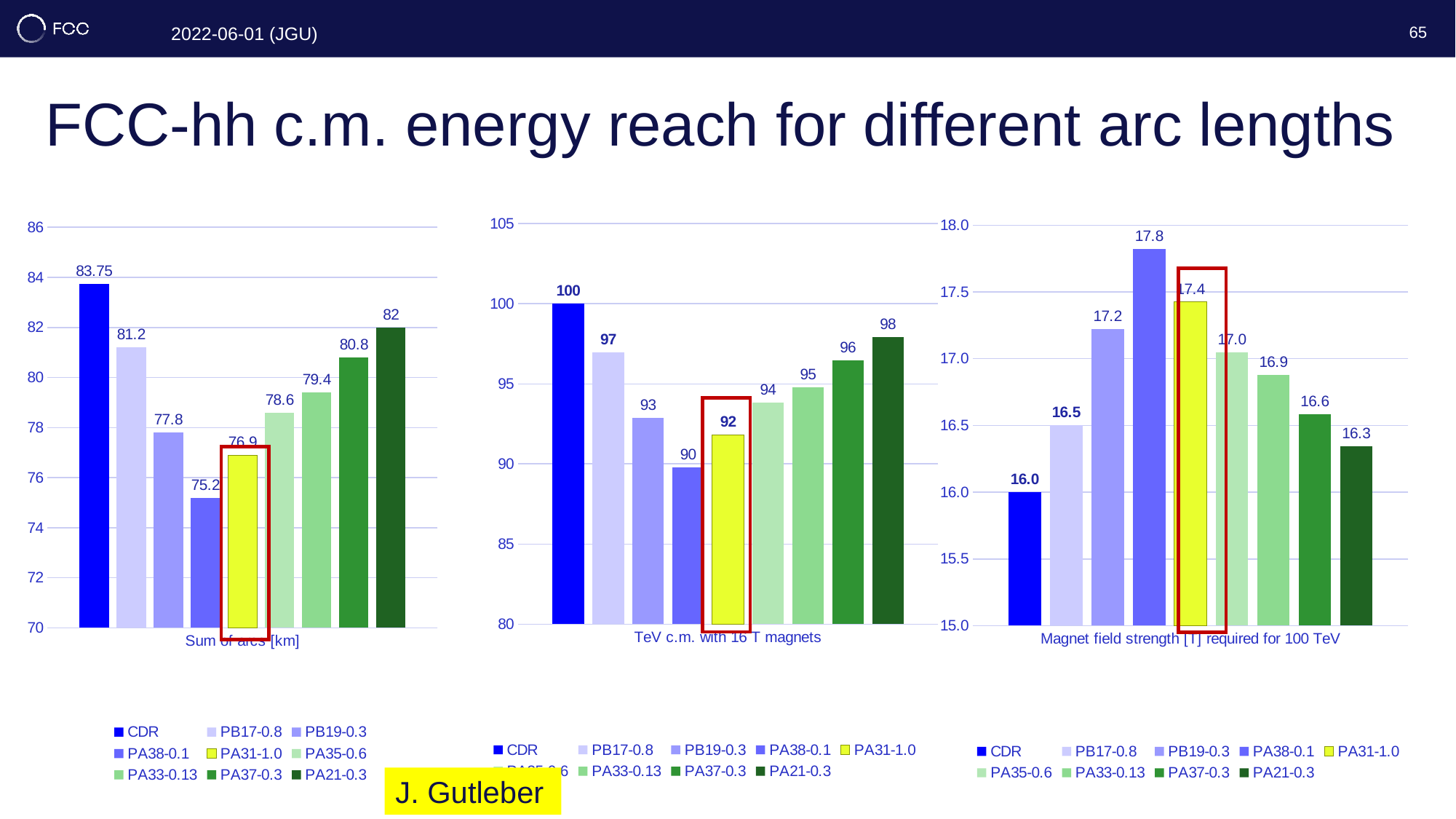
In the 'Sum of arcs [km]' chart, what is the value for CDR? 83.75 In the 'TeV c.m. with 16 T magnets' chart, which is larger, the value for PB19-0.3 or the value for PA33-0.13? PA33-0.13 In the 'TeV c.m. with 16 T magnets' chart, what is the value for PA31-1.0? 92 In the 'Sum of arcs [km]' chart, what is the difference between the CDR value and the PA21-0.3 value? 1.75 In the 'TeV c.m. with 16 T magnets' chart, which series has the highest value? CDR In the 'Magnet field strength [T] required for 100 TeV' chart, what is the difference between the PA38-0.1 value and the PA31-1.0 value? 0.4 What kind of chart is the 'Sum of arcs [km]' chart? bar chart In the 'Magnet field strength [T] required for 100 TeV' chart, is the value for PA21-0.3 greater or less than 16.5? less How many series does the legend of the 'TeV c.m. with 16 T magnets' chart list? 9 In the 'Magnet field strength [T] required for 100 TeV' chart, which series has the lowest value? CDR In the 'Magnet field strength [T] required for 100 TeV' chart, what is the value for PA38-0.1? 17.8 In the 'Sum of arcs [km]' chart, which series has the lowest value? PA38-0.1